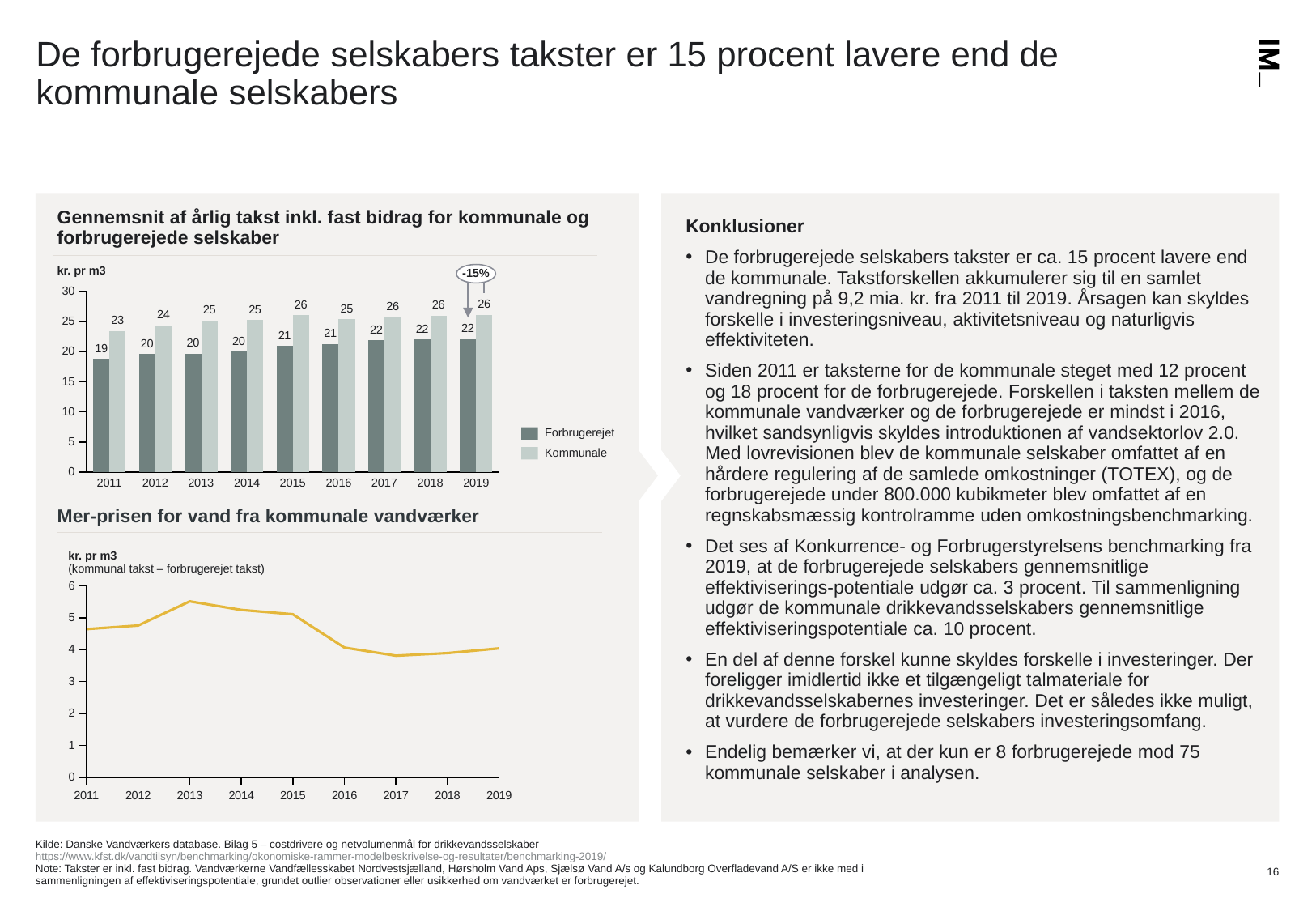
In the line chart 'Mer-prisen for vand fra kommunale vandværker', which year has the highest value? 2013 In the bar chart 'Gennemsnit af årlig takst inkl. fast bidrag for kommunale og forbrugerejede selskaber', what percentage difference is annotated above the 2019 bars? -15% In the bar chart 'Gennemsnit af årlig takst inkl. fast bidrag for kommunale og forbrugerejede selskaber', what is the difference between Kommunale and Forbrugerejet in 2015? 5 How many years are shown on the x axis of the bar chart 'Gennemsnit af årlig takst inkl. fast bidrag for kommunale og forbrugerejede selskaber'? 9 What kind of chart is 'Mer-prisen for vand fra kommunale vandværker'? Line chart In the bar chart 'Gennemsnit af årlig takst inkl. fast bidrag for kommunale og forbrugerejede selskaber', what is the value for Forbrugerejet in 2011? 19 In the line chart 'Mer-prisen for vand fra kommunale vandværker', is the value for 2013 greater or less than 5? greater In the bar chart 'Gennemsnit af årlig takst inkl. fast bidrag for kommunale og forbrugerejede selskaber', what is the value for Kommunale in 2019? 26 In the bar chart 'Gennemsnit af årlig takst inkl. fast bidrag for kommunale og forbrugerejede selskaber', which year has the lowest Forbrugerejet value? 2011 How many series does the legend of the bar chart 'Gennemsnit af årlig takst inkl. fast bidrag for kommunale og forbrugerejede selskaber' list? 2 In the line chart 'Mer-prisen for vand fra kommunale vandværker', is the value for 2017 greater or less than 4? less In the bar chart 'Gennemsnit af årlig takst inkl. fast bidrag for kommunale og forbrugerejede selskaber', which is larger in 2016, Forbrugerejet or Kommunale? Kommunale